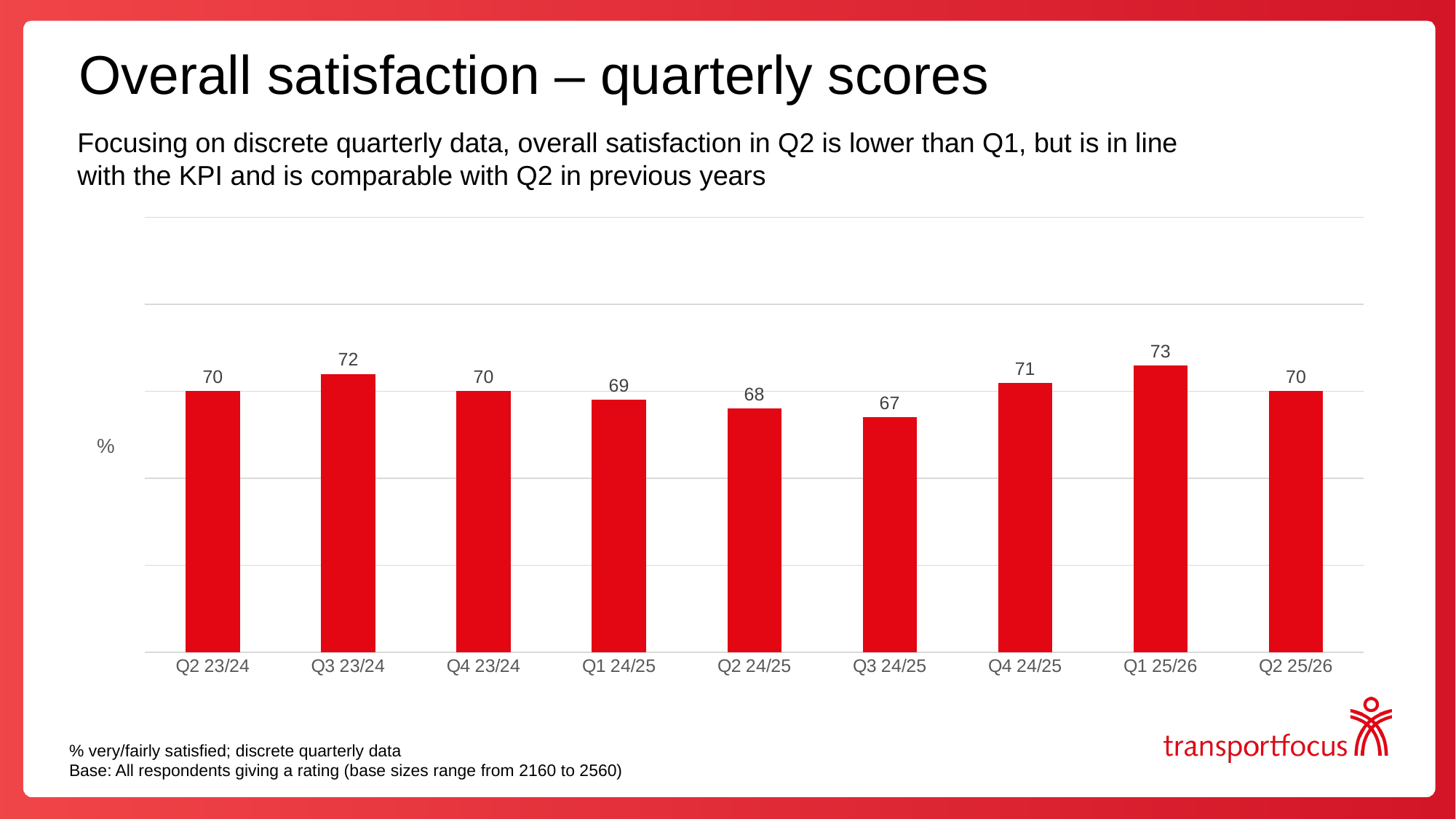
Do the scores rise or fall from Q3 24/25 to Q1 25/26? Rise Which quarter has the lowest overall satisfaction score? Q3 24/25 Which has a higher score, Q4 24/25 or Q2 24/25? Q4 24/25 Which quarter has the highest overall satisfaction score? Q1 25/26 What is the difference between the scores for Q1 25/26 and Q2 25/26? 3 What is the title of the slide? Overall satisfaction – quarterly scores How many quarters are shown on the chart? 9 What is the overall satisfaction score for Q3 23/24? 72 What is the difference between the scores for Q3 23/24 and Q3 24/25? 5 What is the overall satisfaction score for Q3 24/25? 67 What kind of chart is shown on the slide? Bar chart What is the overall satisfaction score for Q2 25/26? 70